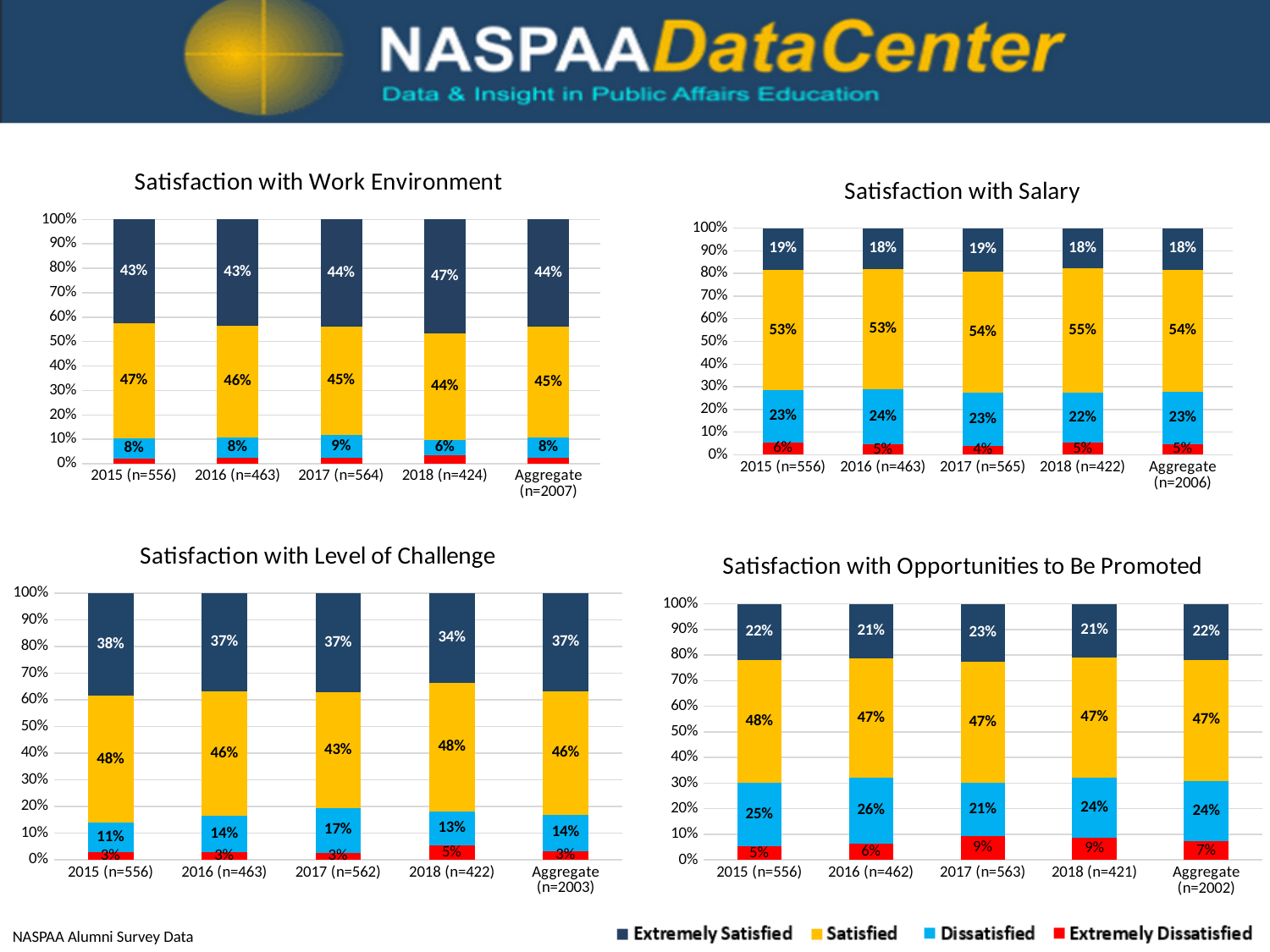
In the Satisfaction with Level of Challenge chart, which year has the highest Dissatisfied share? 2017 (n=562) In the Satisfaction with Salary chart, how many percentage points higher is the Dissatisfied share in 2016 (n=463) than in 2018 (n=422)? 2 percentage points In the Satisfaction with Salary chart, what is the Satisfied share for 2018 (n=422)? 55% According to the legend, which colour represents the Satisfied category? Yellow In the Satisfaction with Work Environment chart, what percentage of 2018 (n=424) respondents were Extremely Satisfied? 47% In the Satisfaction with Opportunities to Be Promoted chart, what is the Extremely Dissatisfied share for 2017 (n=563)? 9% In the Satisfaction with Opportunities to Be Promoted chart, which year has the lowest Dissatisfied share? 2017 (n=563) What type of chart is the Satisfaction with Level of Challenge chart? Stacked bar chart How many bars are shown in the Satisfaction with Salary chart? 5 In the Satisfaction with Level of Challenge chart, does the Extremely Satisfied share rise or fall from 2015 to 2018? Fall In the Satisfaction with Work Environment chart, for 2015 (n=556), which is larger: the Satisfied share or the Extremely Satisfied share? Satisfied How many series does the shared legend at the bottom of the slide list? 4